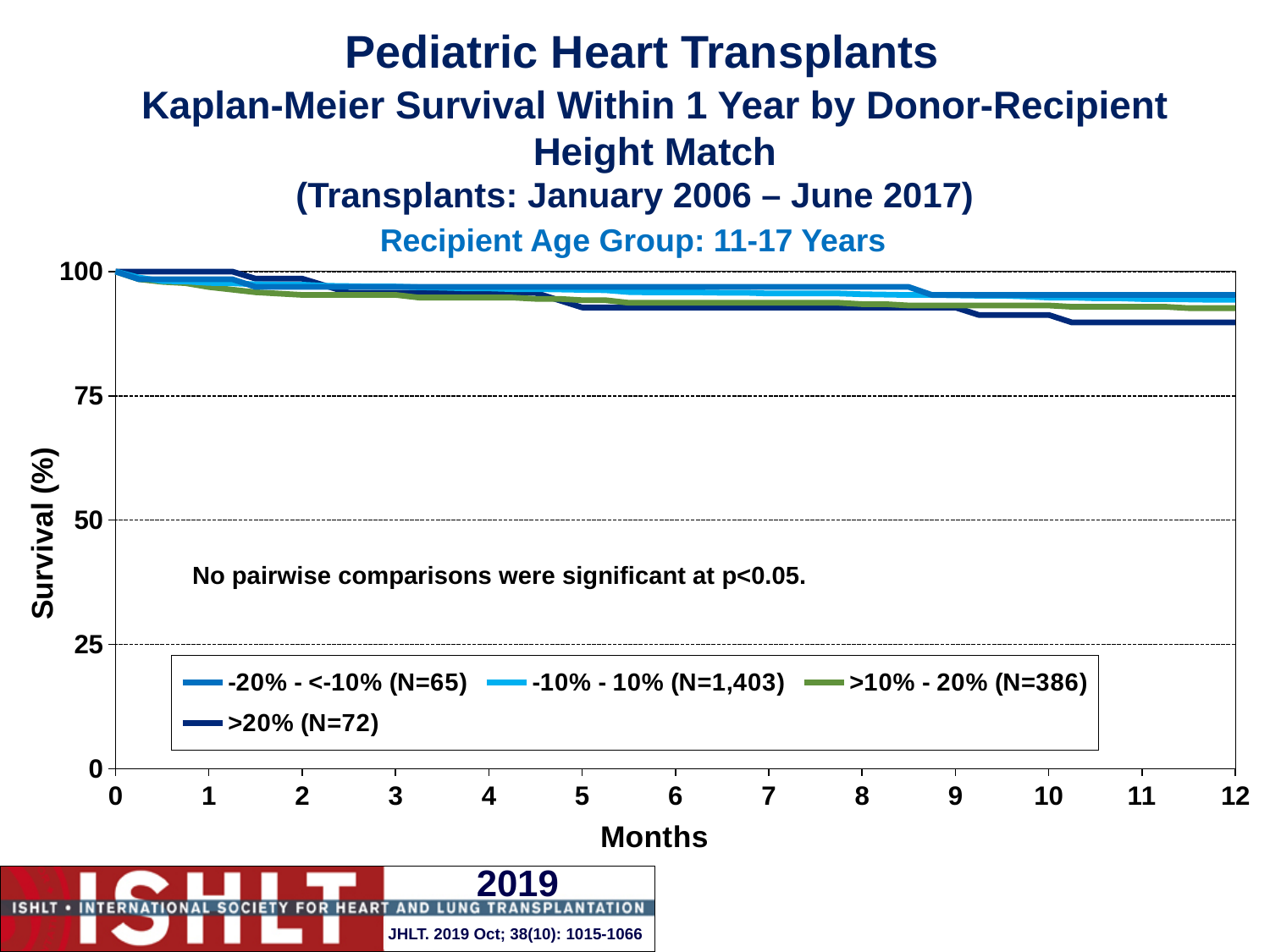
Which height match group has the largest N in the legend? -10% - 10% (N=1,403) Which height match group has the smallest N in the legend? -20% - <-10% (N=65) How many series does the legend list? 4 Do the survival curves rise or fall as months increase? fall Which height match group has the lowest survival at 12 months? >20% (N=72) What is the label of the y axis? Survival (%) Which recipient age group does the chart cover? 11-17 Years What kind of chart is shown on the slide? line chart What is the N for the -10% - 10% height match group shown in the legend? N=1,403 Is the survival for the >20% group at 12 months greater or less than 75? greater What is the N for the >20% height match group shown in the legend? N=72 Is the survival for the -10% - 10% group at 12 months greater or less than 100? less